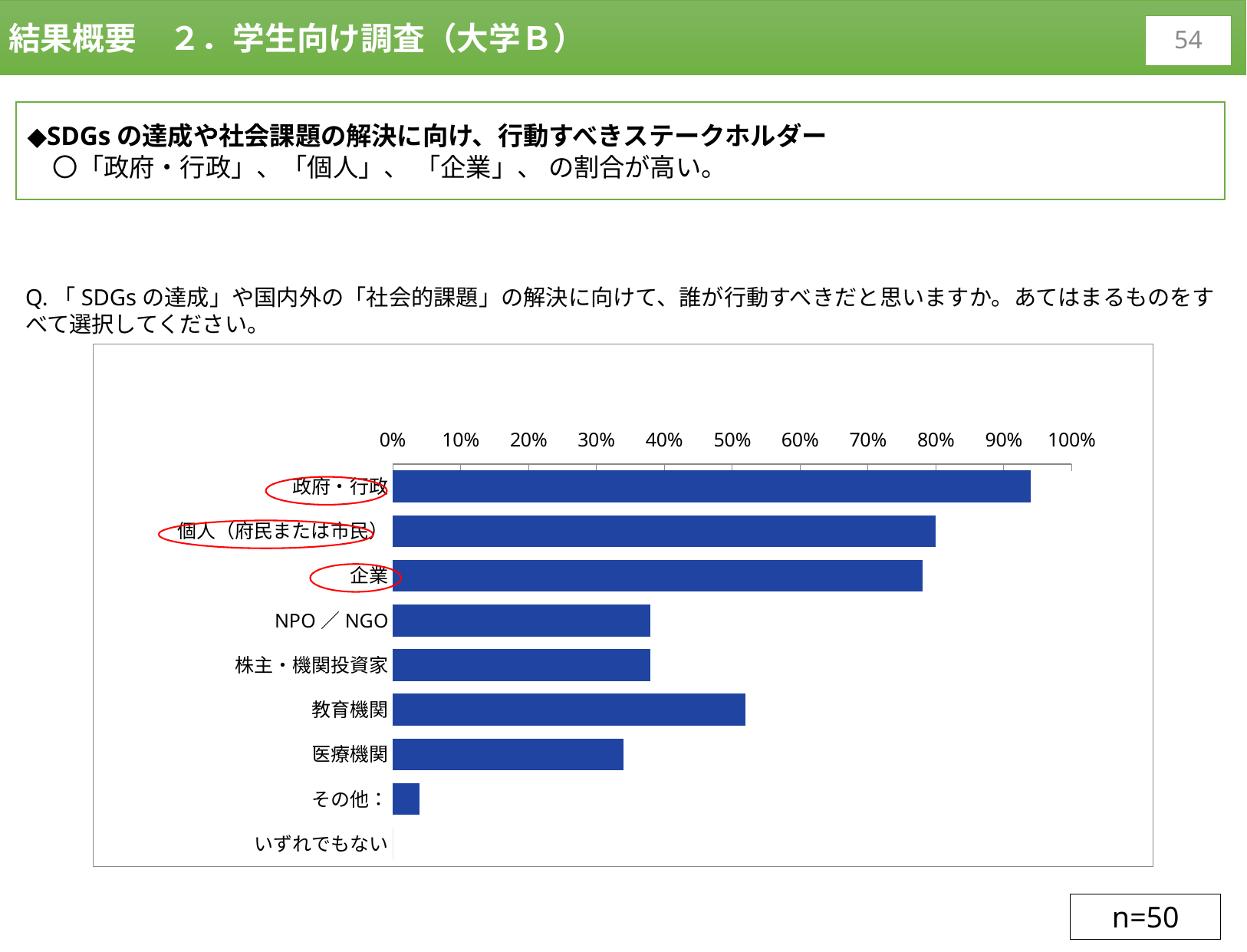
Which category has the highest value in the chart? 政府・行政 Is the value for 政府・行政 greater or less than 90%? greater How many categories are listed on the chart's vertical axis? 9 What kind of chart is shown on the slide? bar chart Which has the larger value, 教育機関 or 医療機関? 教育機関 Is the value for 教育機関 greater or less than 40%? greater Which has the larger value, 政府・行政 or 企業? 政府・行政 Which category has the lowest value in the chart? いずれでもない Is the value for NPO／NGO greater or less than 50%? less What sample size (n) is shown on the slide for this chart? n=50